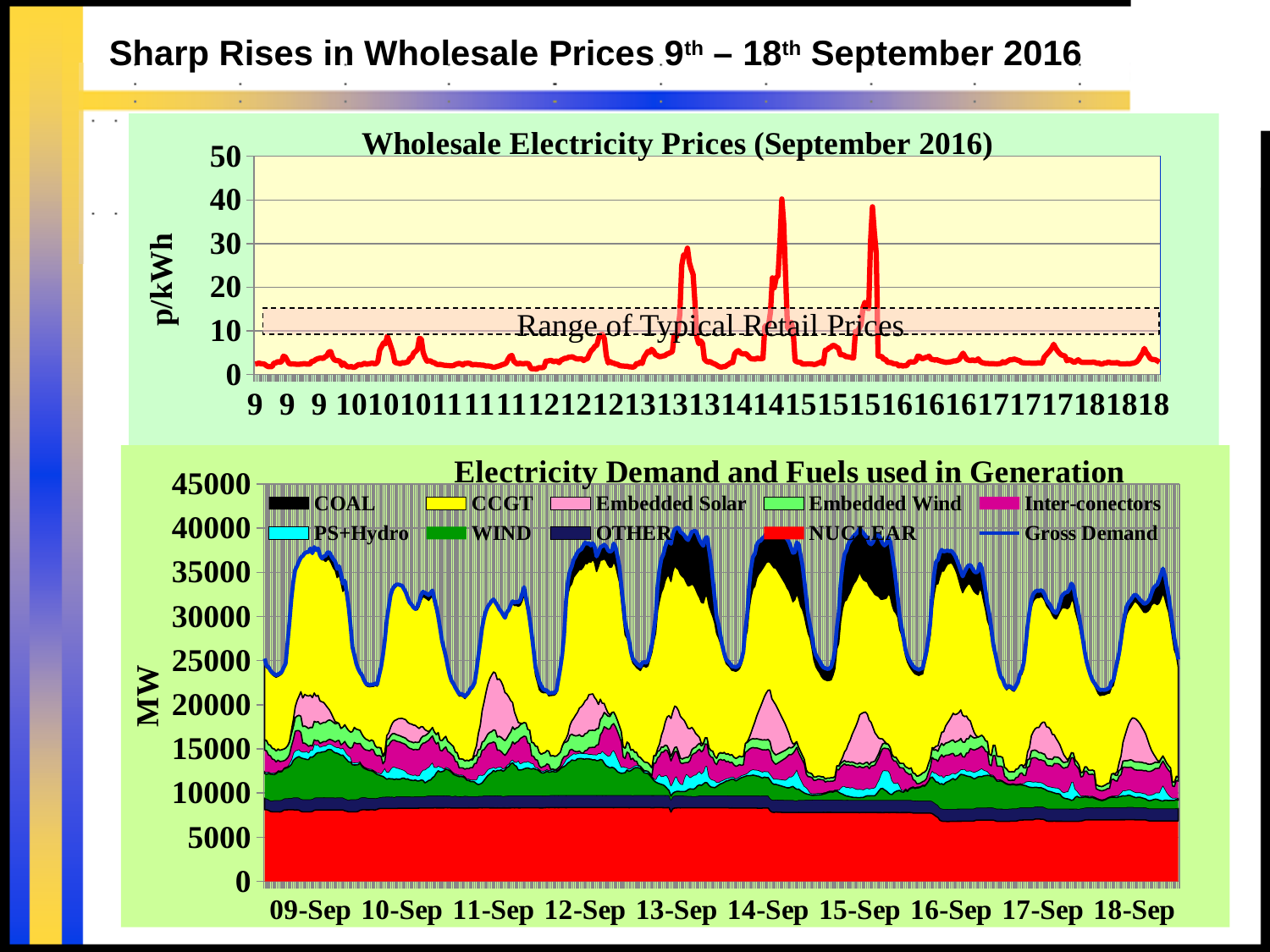
What kind of chart is the bottom chart titled "Electricity Demand and Fuels used in Generation"? stacked area chart In the top chart "Wholesale Electricity Prices (September 2016)", is the price on the 9th greater or less than 10 p/kWh? less In the bottom chart "Electricity Demand and Fuels used in Generation", is the peak Gross Demand on 14-Sep greater or less than 35000 MW? greater In the top chart "Wholesale Electricity Prices (September 2016)", which day has the highest price spike? 14 What is the y-axis label of the bottom chart "Electricity Demand and Fuels used in Generation"? MW In the top chart "Wholesale Electricity Prices (September 2016)", is the price spike on the 15th greater or less than 30 p/kWh? greater How many dates are labelled on the x axis of the bottom chart "Electricity Demand and Fuels used in Generation"? 10 How many series does the legend of the bottom chart "Electricity Demand and Fuels used in Generation" list? 10 What is the y-axis label of the top chart "Wholesale Electricity Prices (September 2016)"? p/kWh What kind of chart is the top chart titled "Wholesale Electricity Prices (September 2016)"? line chart